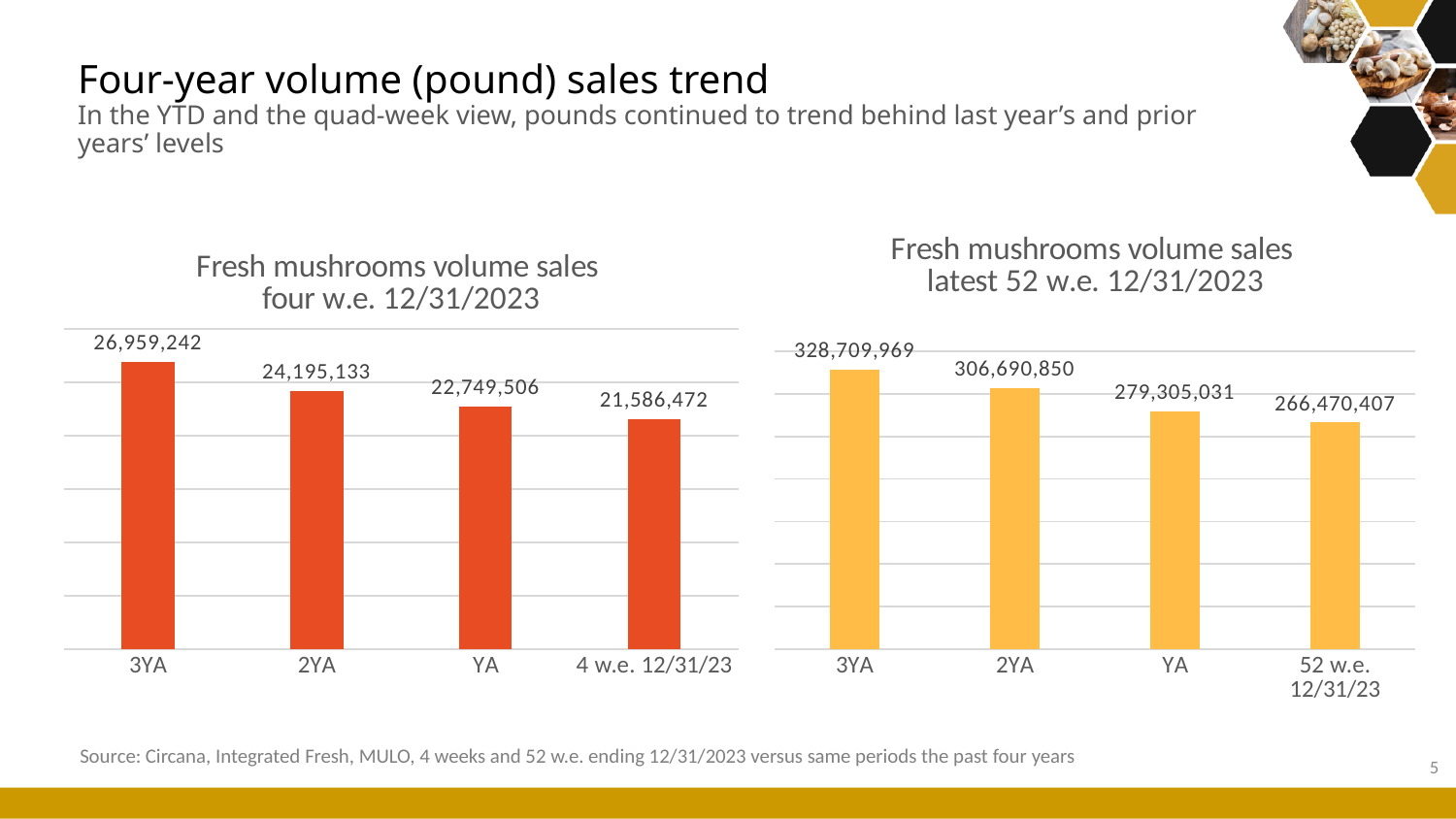
In the 'Fresh mushrooms volume sales latest 52 w.e. 12/31/2023' chart, which category has the lowest value? 52 w.e. 12/31/23 What kind of chart is the 'Fresh mushrooms volume sales latest 52 w.e. 12/31/2023' chart? Bar chart In the 'Fresh mushrooms volume sales four w.e. 12/31/2023' chart, do the values rise or fall from 3YA to 4 w.e. 12/31/23? Fall In the 'Fresh mushrooms volume sales four w.e. 12/31/2023' chart, what is the value for 4 w.e. 12/31/23? 21,586,472 In the 'Fresh mushrooms volume sales latest 52 w.e. 12/31/2023' chart, what is the value for 2YA? 306,690,850 In the 'Fresh mushrooms volume sales latest 52 w.e. 12/31/2023' chart, which is larger, the value for YA or the value for 2YA? 2YA How many categories are shown in the 'Fresh mushrooms volume sales four w.e. 12/31/2023' chart? 4 In the 'Fresh mushrooms volume sales four w.e. 12/31/2023' chart, which category has the highest value? 3YA In the 'Fresh mushrooms volume sales four w.e. 12/31/2023' chart, what is the difference between the 3YA value and the 4 w.e. 12/31/23 value? 5,372,770 In the 'Fresh mushrooms volume sales latest 52 w.e. 12/31/2023' chart, what is the difference between the 2YA value and the YA value? 27,385,819 In the 'Fresh mushrooms volume sales four w.e. 12/31/2023' chart, what is the value for 3YA? 26,959,242 In the 'Fresh mushrooms volume sales latest 52 w.e. 12/31/2023' chart, what is the value for 52 w.e. 12/31/23? 266,470,407